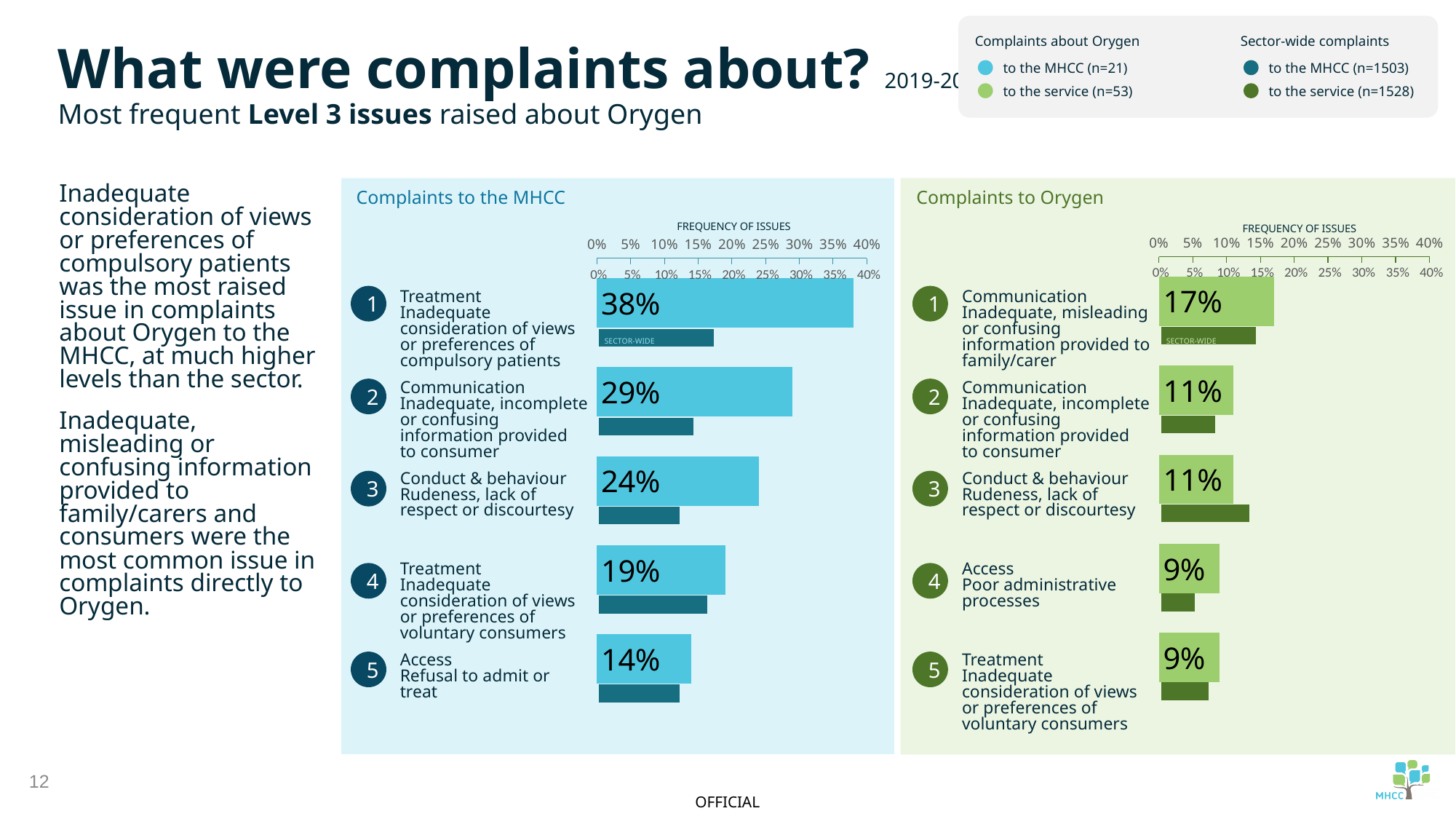
In the 'Complaints to Orygen' chart, what is the difference between the top issue (17%) and 'Conduct & behaviour' (11%)? 6% In the 'Complaints to the MHCC' chart, what is the difference between the frequency for 'Treatment – compulsory patients' (38%) and 'Communication – information provided to consumer' (29%)? 9% In the 'Complaints to the MHCC' chart, what is the frequency for 'Treatment – Inadequate consideration of views or preferences of compulsory patients'? 38% In the 'Complaints to Orygen' chart, what is the frequency for 'Communication – Inadequate, misleading or confusing information provided to family/carer'? 17% In the 'Complaints to the MHCC' chart, is the sector-wide value for 'Treatment – compulsory patients' greater or less than 20%? less What type of chart is used in the 'Complaints to the MHCC' panel? Bar chart In the 'Complaints to the MHCC' chart, which issue has the highest frequency? Treatment – Inadequate consideration of views or preferences of compulsory patients How many issues are listed in the 'Complaints to Orygen' chart? 5 In the 'Complaints to the MHCC' chart, what is the frequency for 'Access – Refusal to admit or treat'? 14% Which is larger: the frequency of 'Conduct & behaviour' in the 'Complaints to the MHCC' chart or in the 'Complaints to Orygen' chart? Complaints to the MHCC (24%) In the 'Complaints to Orygen' chart, which issue has the highest frequency? Communication – Inadequate, misleading or confusing information provided to family/carer In the 'Complaints to Orygen' chart, what is the frequency for 'Access – Poor administrative processes'? 9%